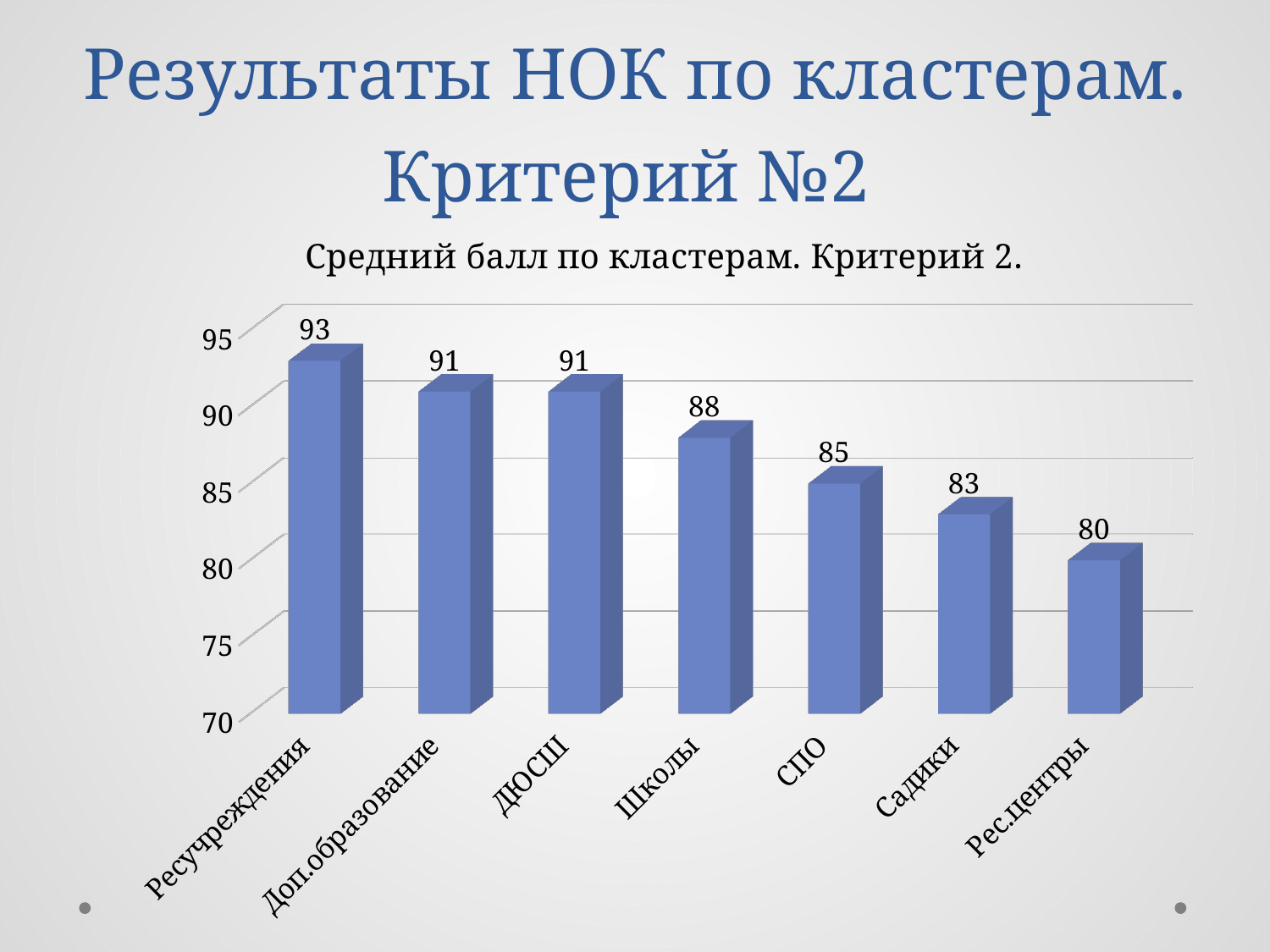
What is the title of the chart? Средний балл по кластерам. Критерий 2. Which category has the lowest value? Рес.центры Is the value for Садики greater or less than 85? less Which is larger, the value for ДЮСШ or the value for СПО? ДЮСШ What is the difference between the values for Ресучреждения and Рес.центры? 13 What is the value for СПО? 85 What is the difference between the values for Школы and Садики? 5 Which category has the highest value? Ресучреждения What is the value for Рес.центры? 80 What kind of chart is shown on the slide? bar chart How many categories are shown on the chart? 7 What is the value for Школы? 88